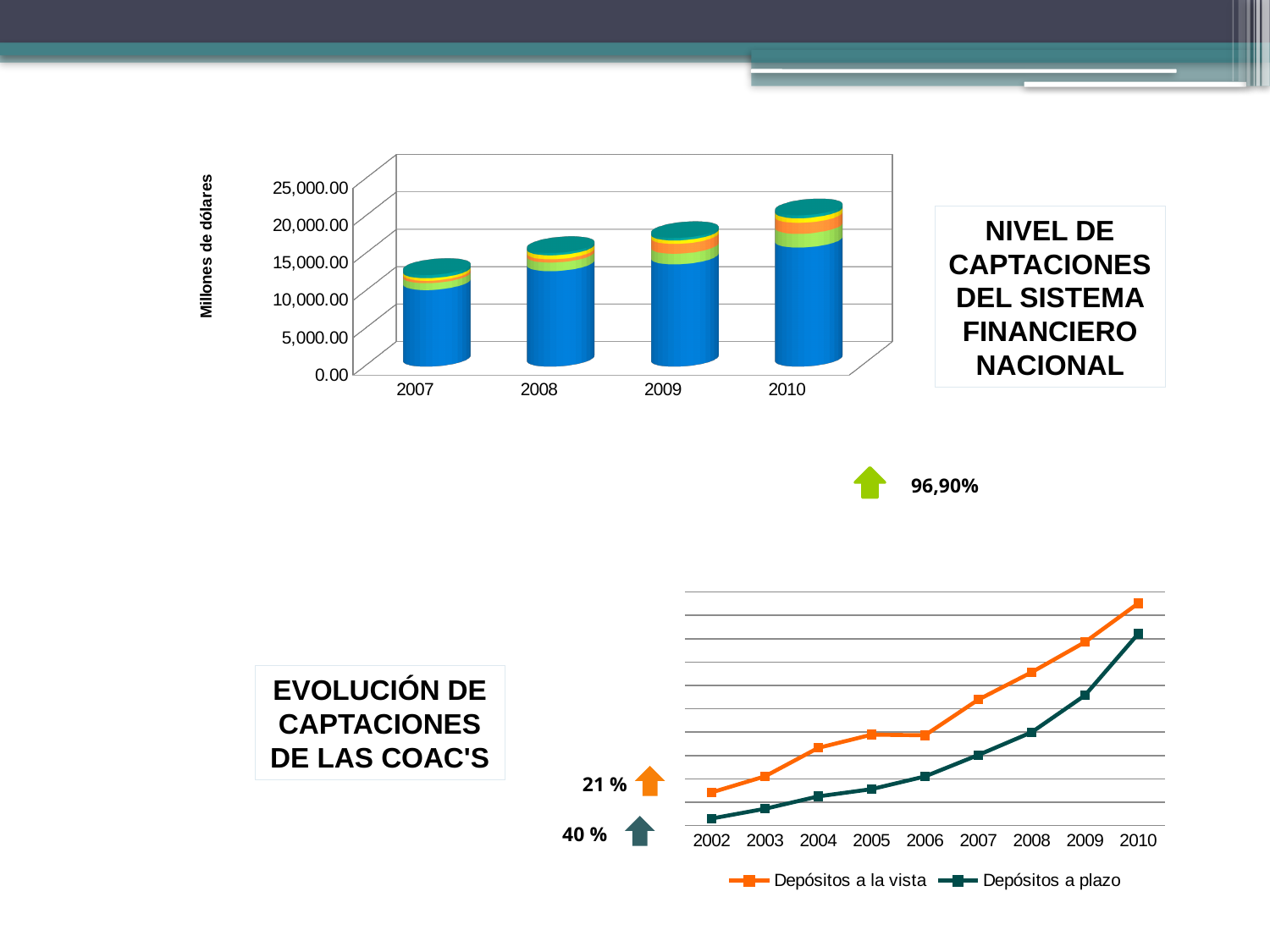
How many series does the legend of the bottom chart 'EVOLUCIÓN DE CAPTACIONES DE LAS COAC'S' list? 2 What is the y-axis label of the top chart 'NIVEL DE CAPTACIONES DEL SISTEMA FINANCIERO NACIONAL'? Millones de dólares In the top chart 'NIVEL DE CAPTACIONES DEL SISTEMA FINANCIERO NACIONAL', is the total for 2008 greater or less than 20,000.00? less In the top chart 'NIVEL DE CAPTACIONES DEL SISTEMA FINANCIERO NACIONAL', do the stacked bar totals rise or fall from 2007 to 2010? rise What kind of chart is the top chart titled 'NIVEL DE CAPTACIONES DEL SISTEMA FINANCIERO NACIONAL'? bar chart In the top chart 'NIVEL DE CAPTACIONES DEL SISTEMA FINANCIERO NACIONAL', how many years are shown on the x axis? 4 In the top chart 'NIVEL DE CAPTACIONES DEL SISTEMA FINANCIERO NACIONAL', is the total for 2007 greater or less than 10,000.00? greater In the bottom chart 'EVOLUCIÓN DE CAPTACIONES DE LAS COAC'S', how many years are shown on the x axis? 9 In the top chart 'NIVEL DE CAPTACIONES DEL SISTEMA FINANCIERO NACIONAL', which year has the tallest stacked bar? 2010 In the bottom chart 'EVOLUCIÓN DE CAPTACIONES DE LAS COAC'S', which series is higher in 2010, Depósitos a la vista or Depósitos a plazo? Depósitos a la vista In the top chart 'NIVEL DE CAPTACIONES DEL SISTEMA FINANCIERO NACIONAL', which year has the shortest stacked bar? 2007 What kind of chart is the bottom chart titled 'EVOLUCIÓN DE CAPTACIONES DE LAS COAC'S'? line chart